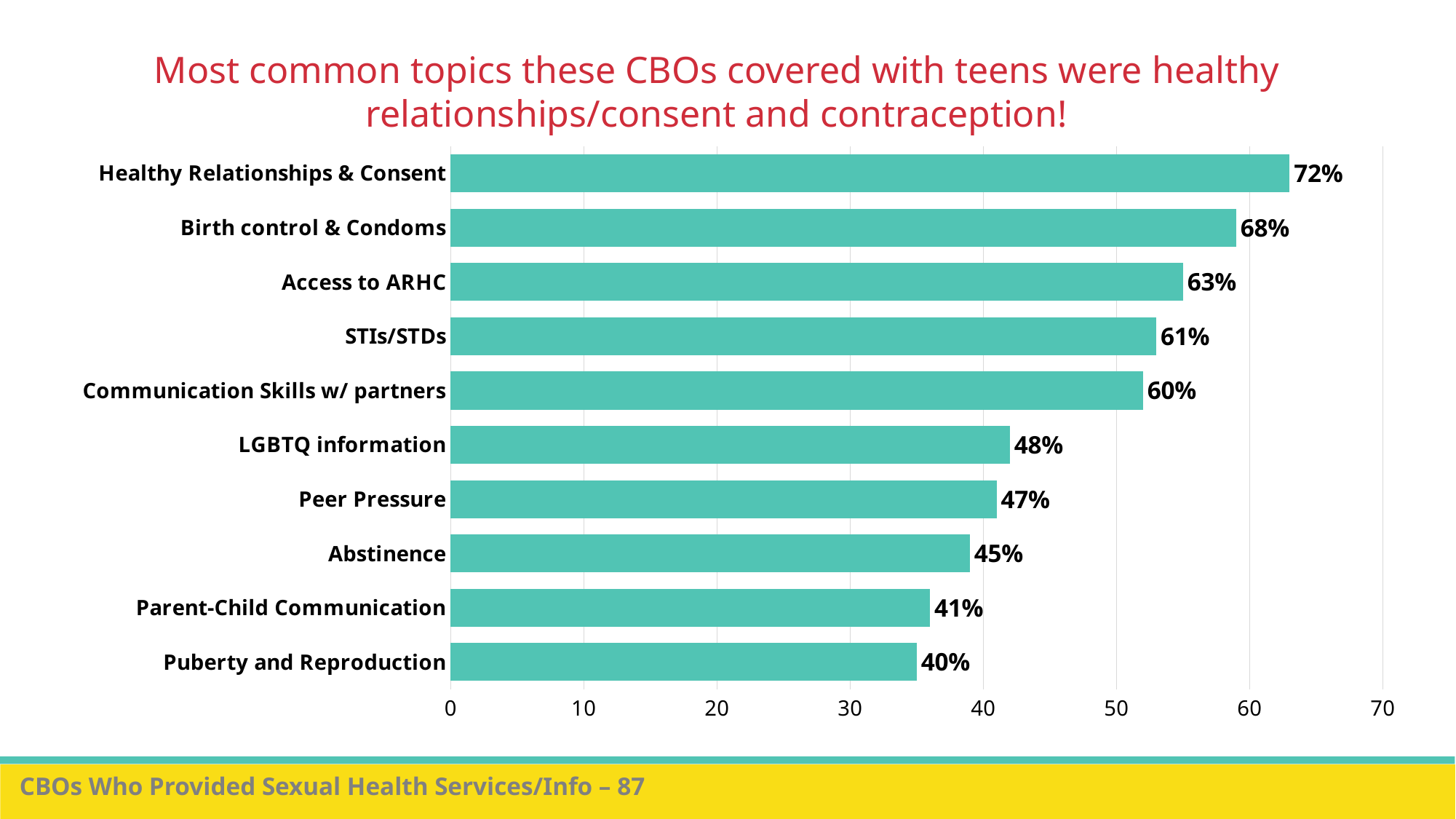
What is the text in the yellow banner at the bottom of the slide? CBOs Who Provided Sexual Health Services/Info – 87 What is the difference between the values for Birth control & Condoms and Abstinence? 23% What value is shown for Healthy Relationships & Consent? 72% Which topic has the lowest value? Puberty and Reproduction What value is shown for LGBTQ information? 48% Which has a larger value, Access to ARHC or Communication Skills w/ partners? Access to ARHC Which topic has the highest value? Healthy Relationships & Consent How many topics are shown in the chart? 10 Which has a larger value, Abstinence or Puberty and Reproduction? Abstinence What is the difference between the values for STIs/STDs and Peer Pressure? 14% What value is shown for Parent-Child Communication? 41% What kind of chart is shown on the slide? Bar chart